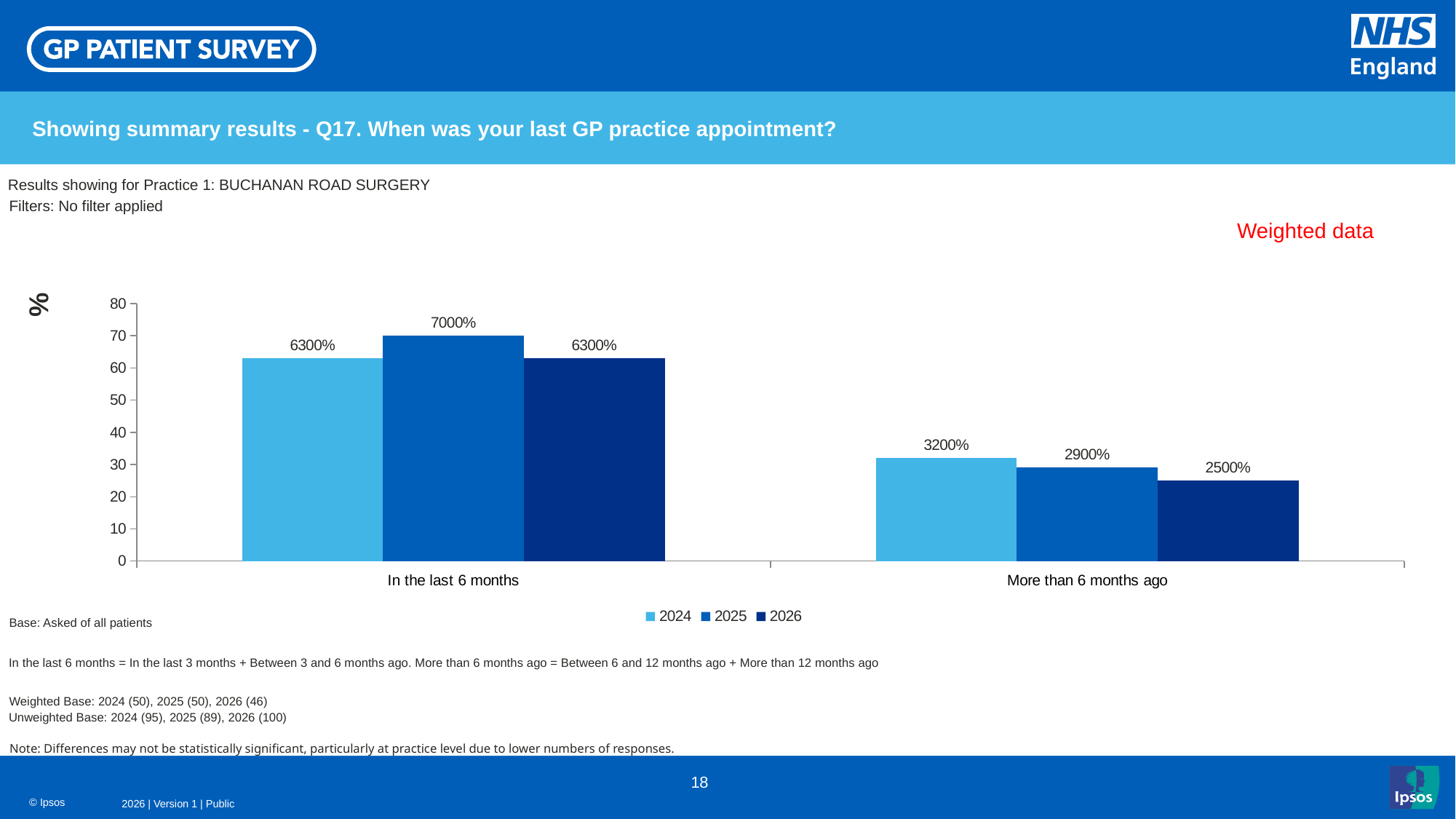
Which practice are the results shown for? Practice 1: BUCHANAN ROAD SURGERY Is the 2026 bar for 'More than 6 months ago' greater or less than 30 on the axis? less Which year has the lowest bar in the 'More than 6 months ago' category? 2026 What is the data label shown for 2024 in the 'More than 6 months ago' category? 3200% How many categories are shown on the x axis? 2 What is the data label shown for 2025 in the 'In the last 6 months' category? 7000% In the 'More than 6 months ago' category, which bar is taller: 2024 or 2026? 2024 What is the data label shown for 2026 in the 'More than 6 months ago' category? 2500% Which year has the highest bar in the 'In the last 6 months' category? 2025 How many series does the legend list? 3 Is the 2025 bar for 'In the last 6 months' greater or less than 60 on the axis? greater What kind of chart is shown on the slide? Bar chart